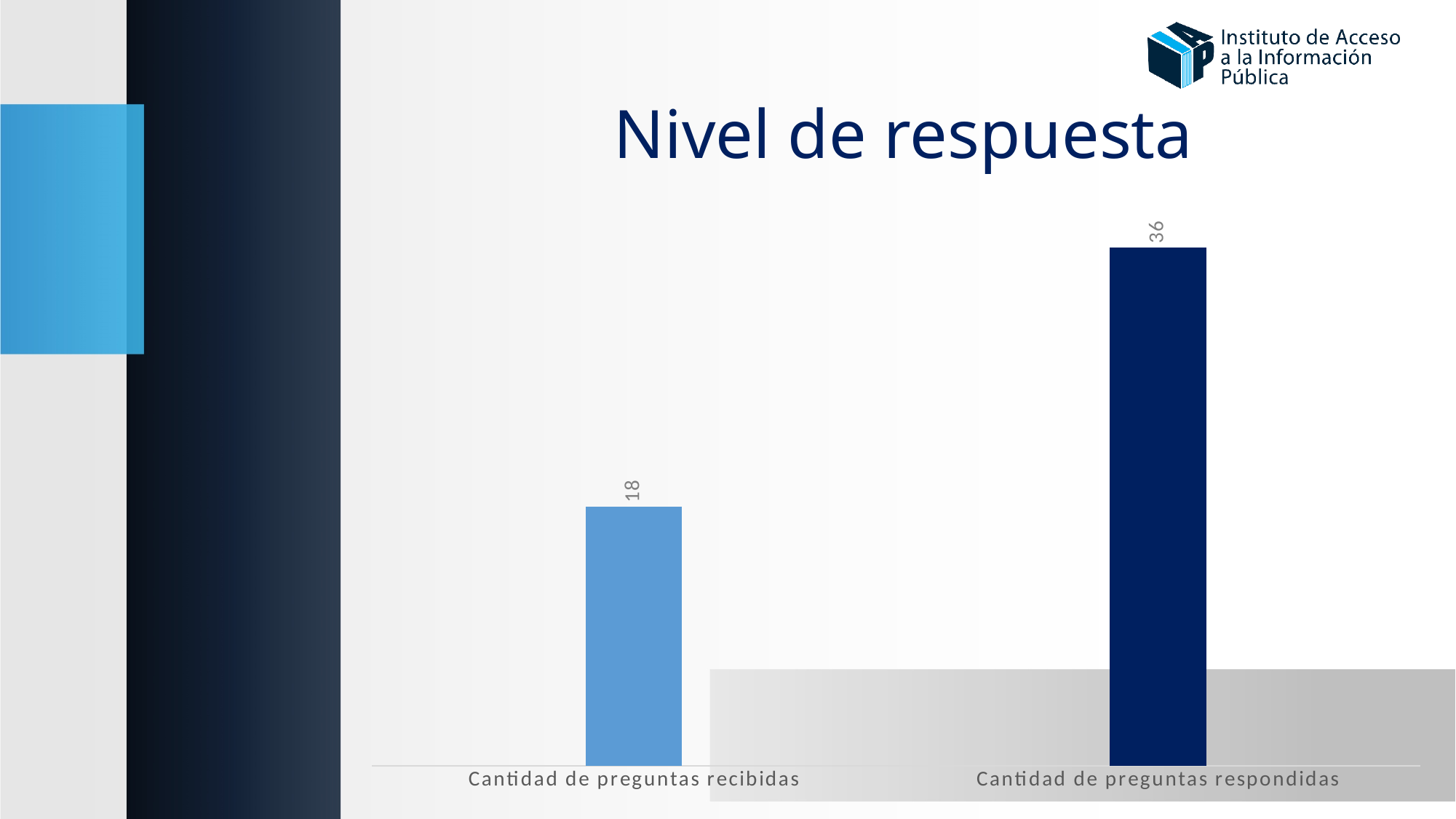
What kind of chart is shown on the slide? Bar chart Do the values rise or fall from left to right across the categories? Rise What is the value for "Cantidad de preguntas recibidas"? 18 How many categories are shown in the chart? 2 What colour is the bar for "Cantidad de preguntas respondidas"? Dark navy blue What is the difference between the values for "Cantidad de preguntas respondidas" and "Cantidad de preguntas recibidas"? 18 Which category has the lowest value? Cantidad de preguntas recibidas What is the title of the slide containing the chart? Nivel de respuesta Which category has the highest value? Cantidad de preguntas respondidas What is the value for "Cantidad de preguntas respondidas"? 36 Which is larger: the value for "Cantidad de preguntas recibidas" or for "Cantidad de preguntas respondidas"? Cantidad de preguntas respondidas